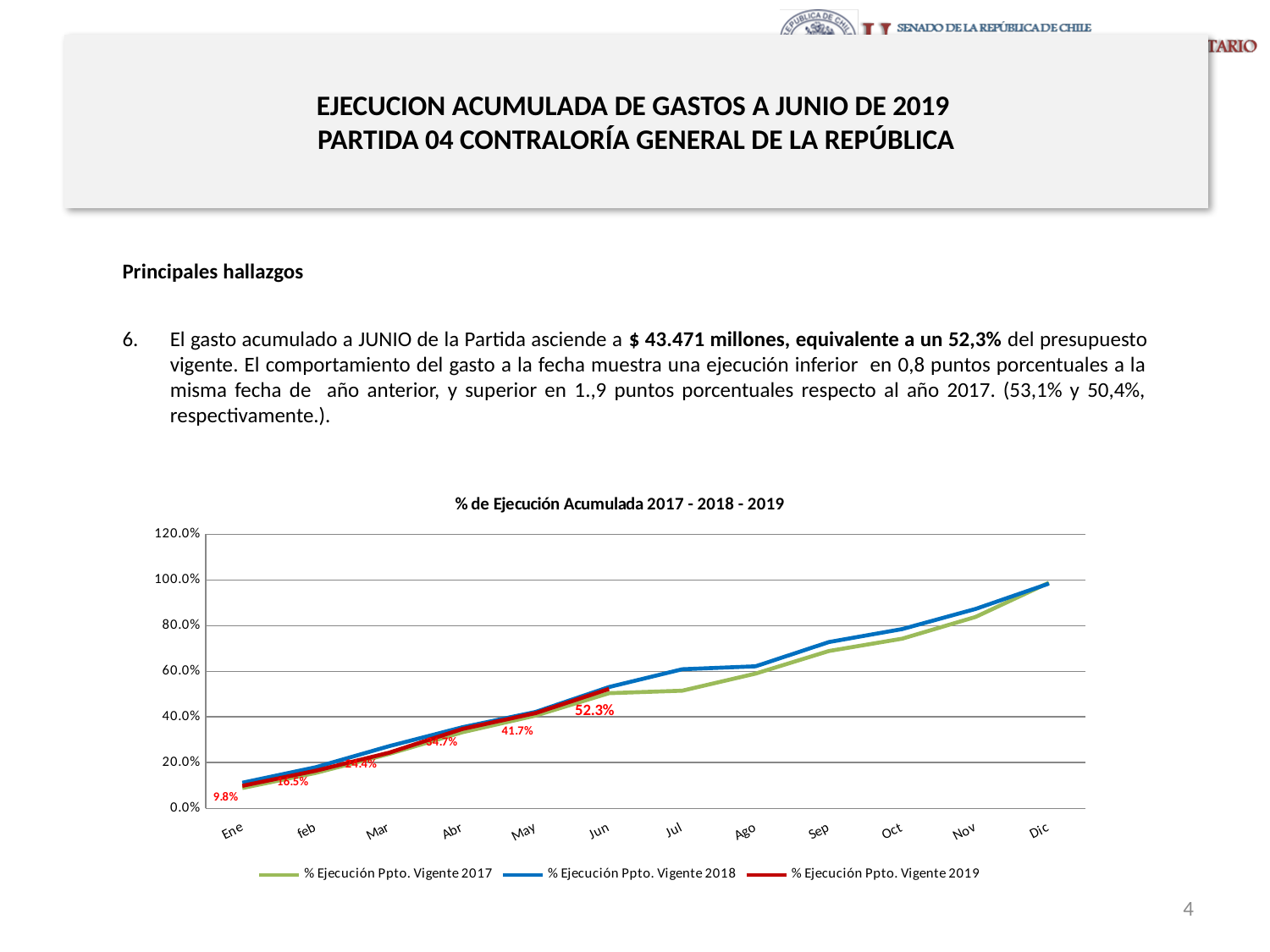
How many series does the legend of the chart list? 3 What is the value of % Ejecución Ppto. Vigente 2019 in Feb? 16.5% What is the title of the chart? % de Ejecución Acumulada 2017 - 2018 - 2019 What is the value of % Ejecución Ppto. Vigente 2019 in May? 41.7% How many months are shown along the x axis of the chart? 12 What kind of chart is shown on the slide? line chart By how much did % Ejecución Ppto. Vigente 2019 increase from May to Jun? 10.6% Does the % Ejecución Ppto. Vigente 2018 series rise or fall from Ene to Dic? rise Is the value for % Ejecución Ppto. Vigente 2018 in Dic greater or less than 80%? greater What is the value of % Ejecución Ppto. Vigente 2019 in Jun? 52.3% What is the value of % Ejecución Ppto. Vigente 2019 in Ene? 9.8% In which month does the % Ejecución Ppto. Vigente 2019 series reach its highest value? Jun